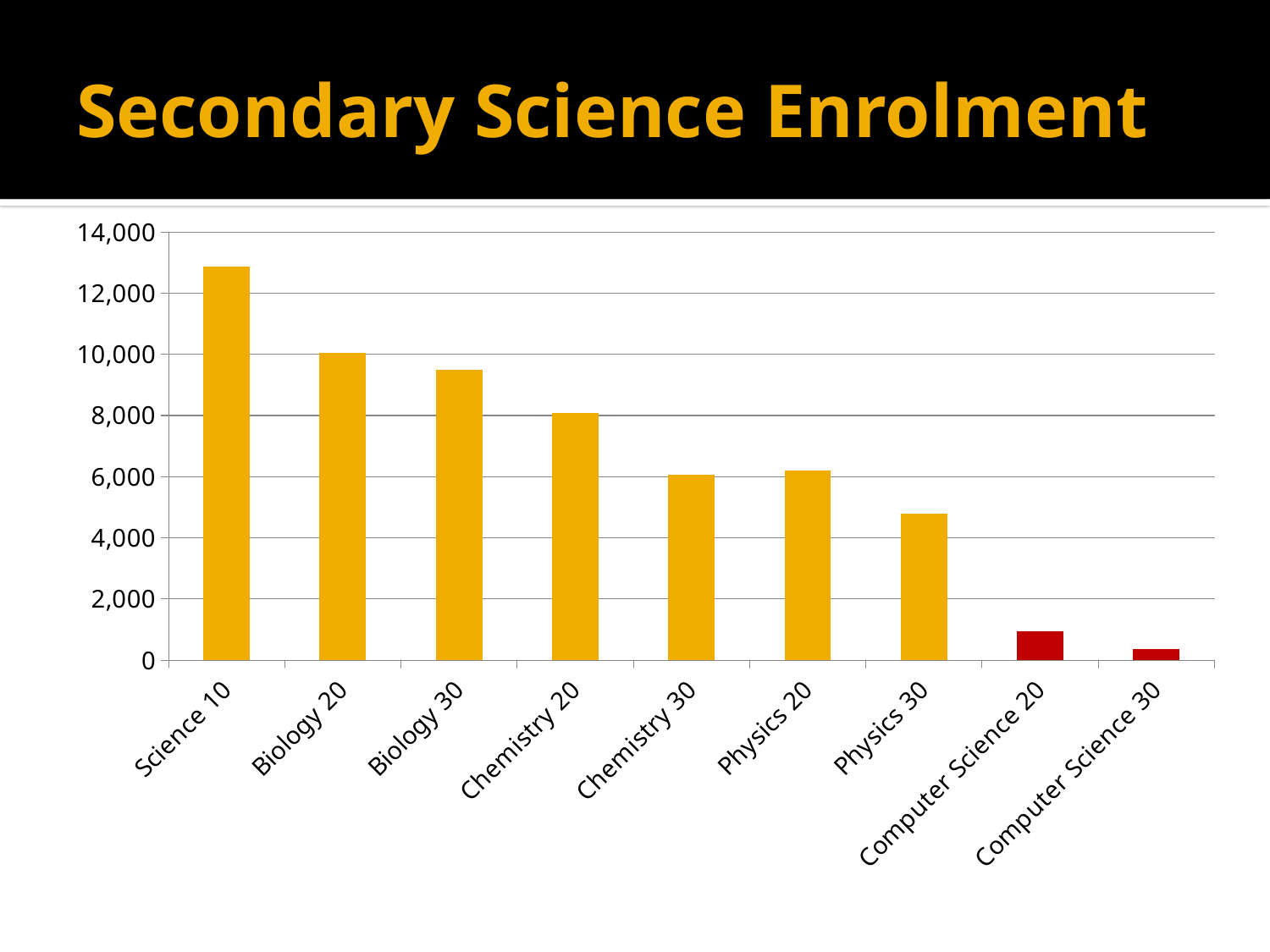
Is the value for Science 10 greater or less than 12,000? greater What kind of chart is shown on the slide? bar chart Is the value for Biology 30 greater or less than 10,000? less What is the title of the slide? Secondary Science Enrolment Which is larger, the value for Biology 20 or the value for Biology 30? Biology 20 Which is larger, the value for Chemistry 20 or the value for Physics 30? Chemistry 20 Is the value for Physics 30 greater or less than 4,000? greater Which course has the highest enrolment? Science 10 How many courses are shown on the x axis of the chart? 9 Which course has the lowest enrolment? Computer Science 30 Which bars are coloured red rather than yellow? Computer Science 20 and Computer Science 30